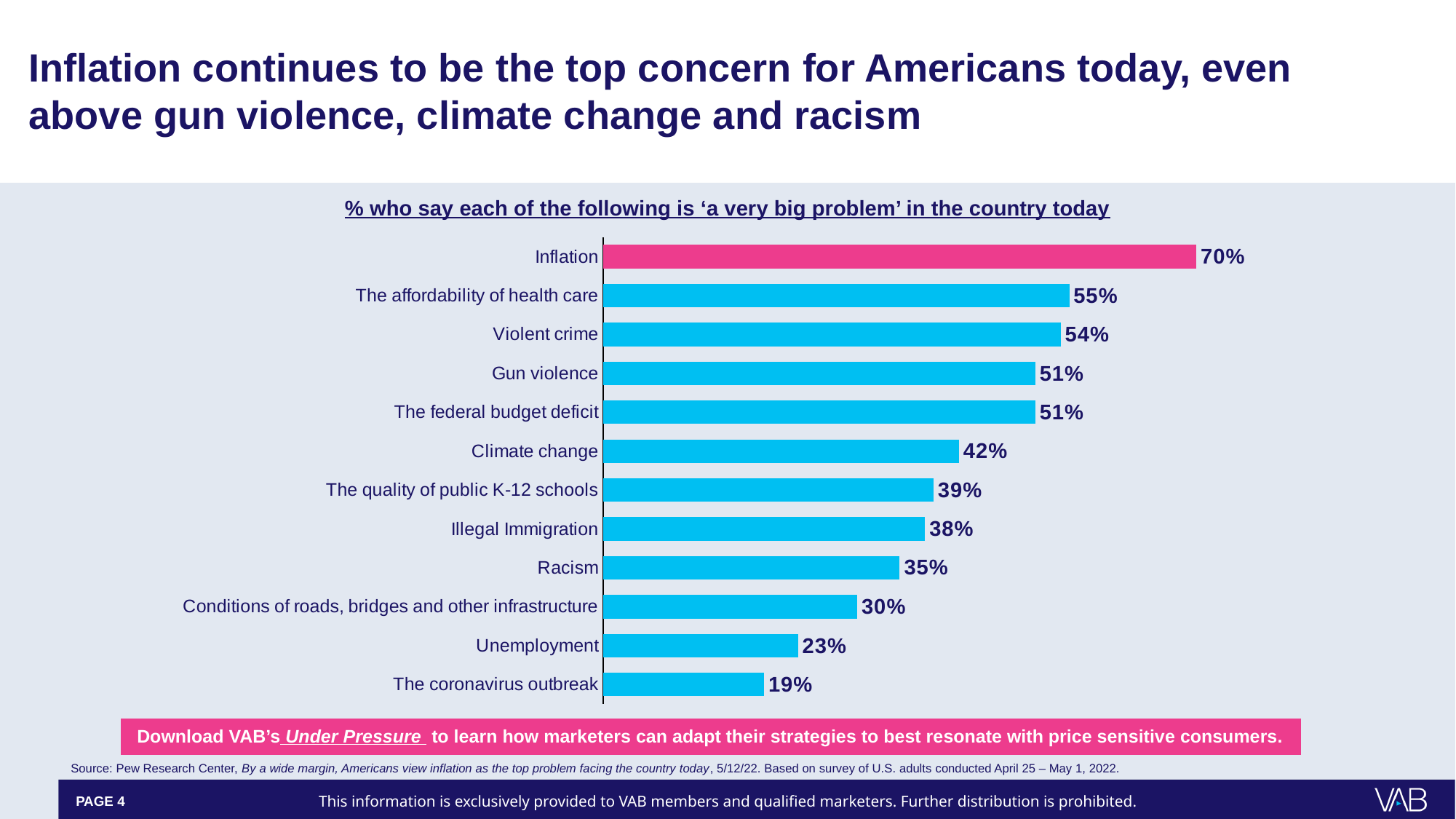
Which two categories share the same value of 51%? Gun violence and The federal budget deficit What is the difference between the values for Inflation and Gun violence? 19 percentage points What is the difference between the values for Racism and Unemployment? 12 percentage points What is the value shown for The coronavirus outbreak? 19% Which category has the highest value on the chart? Inflation Which bar is coloured differently (pink) from the others? Inflation What is the value shown for Climate change? 42% How many categories are shown on the chart? 12 What percentage of Americans say inflation is 'a very big problem'? 70% What kind of chart is shown on the slide? Bar chart Which category has the lowest value on the chart? The coronavirus outbreak Which is larger, the value for Violent crime or the value for Illegal Immigration? Violent crime